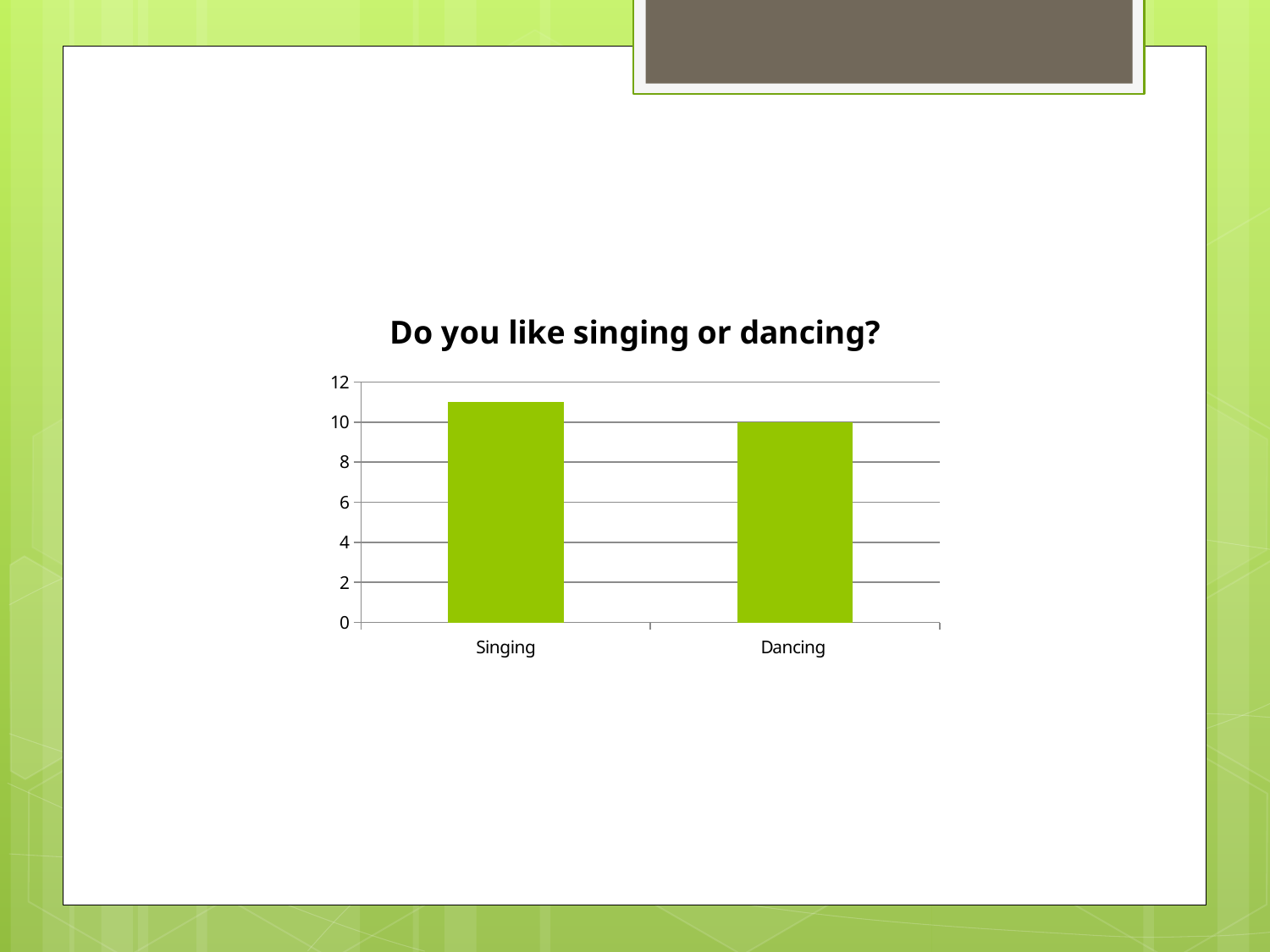
How many categories are shown on the x axis? 2 Is the value for Singing greater or less than 12? less Is the value for Singing greater or less than 10? greater What colour are the bars in the chart? Green Which category has the highest value? Singing What is the title of the chart? Do you like singing or dancing? Which is larger, the value for Singing or the value for Dancing? Singing Is the value for Dancing greater or less than 8? greater Which category has the lowest value? Dancing What is the highest value shown on the y axis? 12 What is the value for Dancing? 10 What kind of chart is shown on the slide? Bar chart